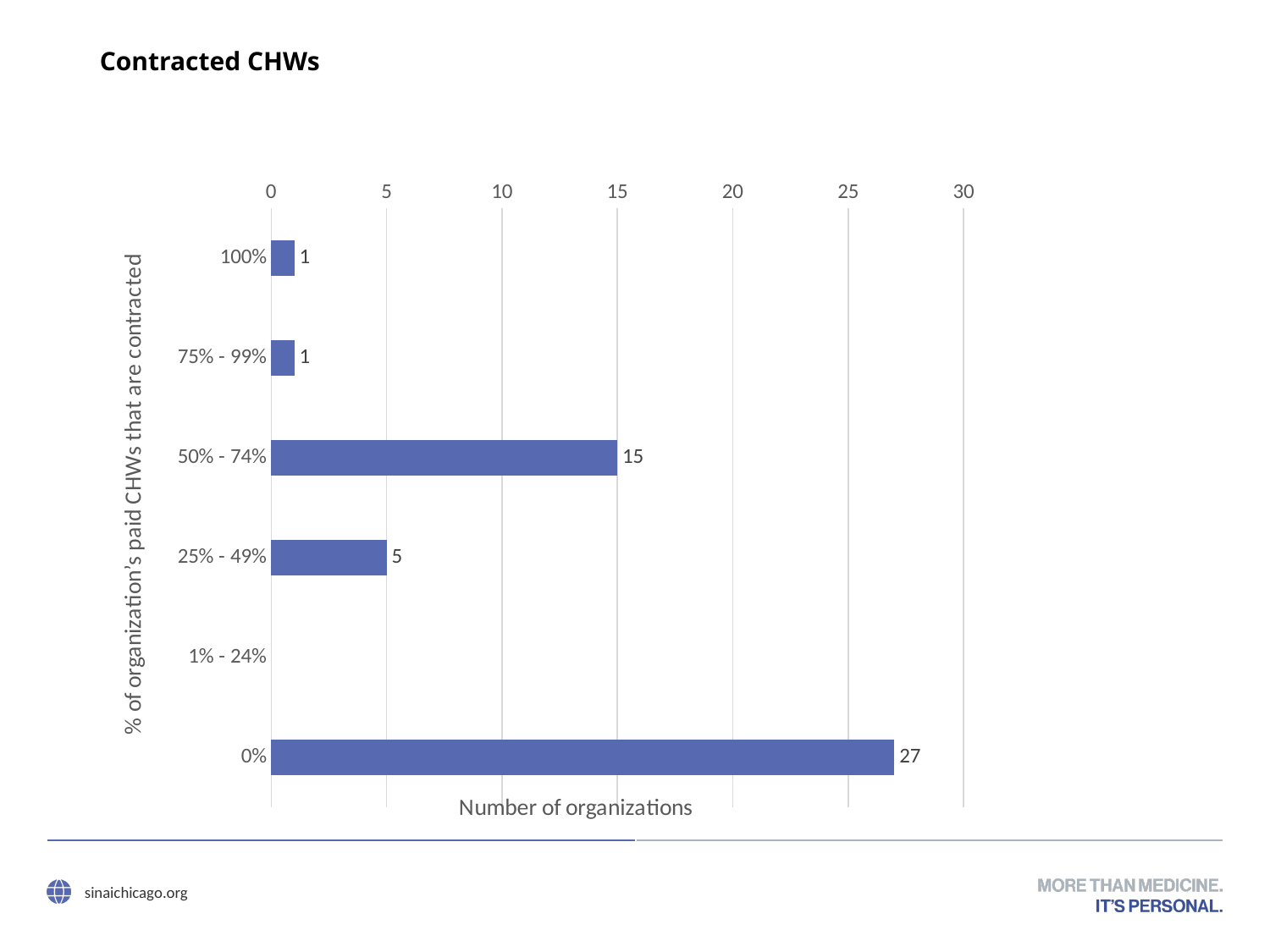
What is the title of the chart? Contracted CHWs How many organizations have 100% of their paid CHWs contracted? 1 How many categories are shown on the y axis of the chart? 6 What is the number of organizations for the 25% - 49% category? 5 Which category has the highest number of organizations? 0% Is the value for the 0% category greater or less than 25? greater How many organizations fall in the 50% - 74% category? 15 How many organizations have 0% of their paid CHWs contracted? 27 What is the difference in number of organizations between the 0% category and the 50% - 74% category? 12 What is the label of the x axis? Number of organizations Which has more organizations, the 25% - 49% category or the 50% - 74% category? 50% - 74% What kind of chart is shown on the slide? Bar chart